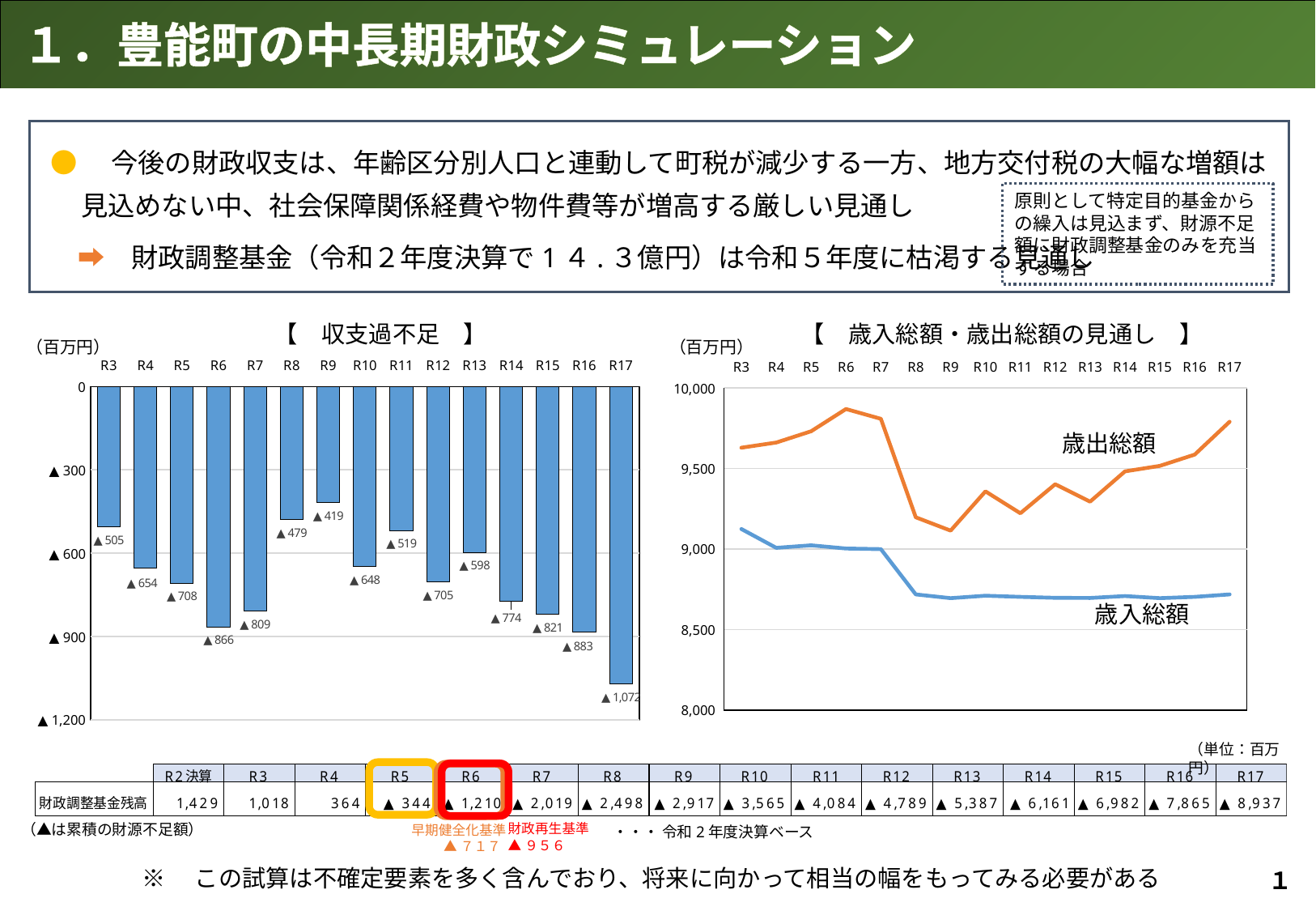
How many series are shown in the 歳入総額・歳出総額の見通し chart? 2 In the 歳入総額・歳出総額の見通し chart, is the 歳入総額 value for R10 greater or less than 9,000? less In the 収支過不足 chart, which year has the smallest deficit (shortest bar)? R9 How many years are plotted in the 収支過不足 chart? 15 In the 歳入総額・歳出総額の見通し chart, is the 歳出総額 value for R6 greater or less than 9,500? greater What type of chart is the 収支過不足 chart? Bar chart In the 収支過不足 chart, what is the difference between the R17 value (1,072) and the R16 value (883)? 189 In the 収支過不足 chart, which year has the largest deficit (longest bar)? R17 In the 収支過不足 chart, which year has the larger deficit, R4 or R5? R5 In the 収支過不足 chart, what is the value for R6? ▲ 866 In the 収支過不足 chart, what is the value for R9? ▲ 419 In the 収支過不足 chart, what is the value for R17? ▲ 1,072